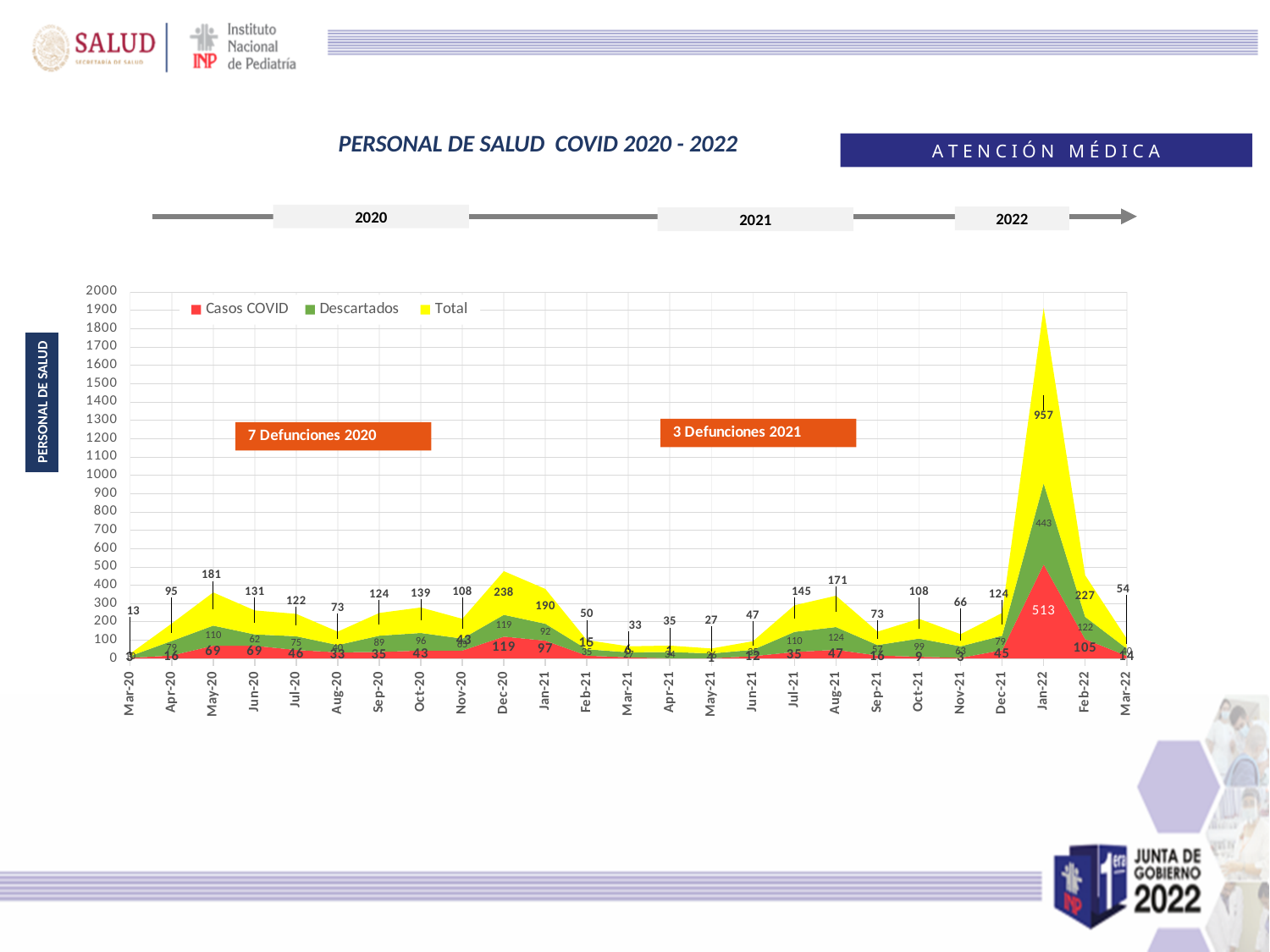
What is the title of the chart? PERSONAL DE SALUD COVID 2020 - 2022 What is the difference between the Total values for Jan-22 and Feb-22? 730 Which month has the lowest Total value? Mar-20 How many months are plotted along the x axis? 25 What kind of chart is shown on the slide? Area chart What is the Casos COVID value labelled for Jan-22? 513 What is the Descartados value labelled for Jan-22? 443 Which month has the larger Total value, Dec-20 or Jan-21? Dec-20 How many series does the legend list? 3 Which month has the highest Total value? Jan-22 What is the Total value labelled for Jan-22? 957 What is the Total value labelled for Dec-20? 238